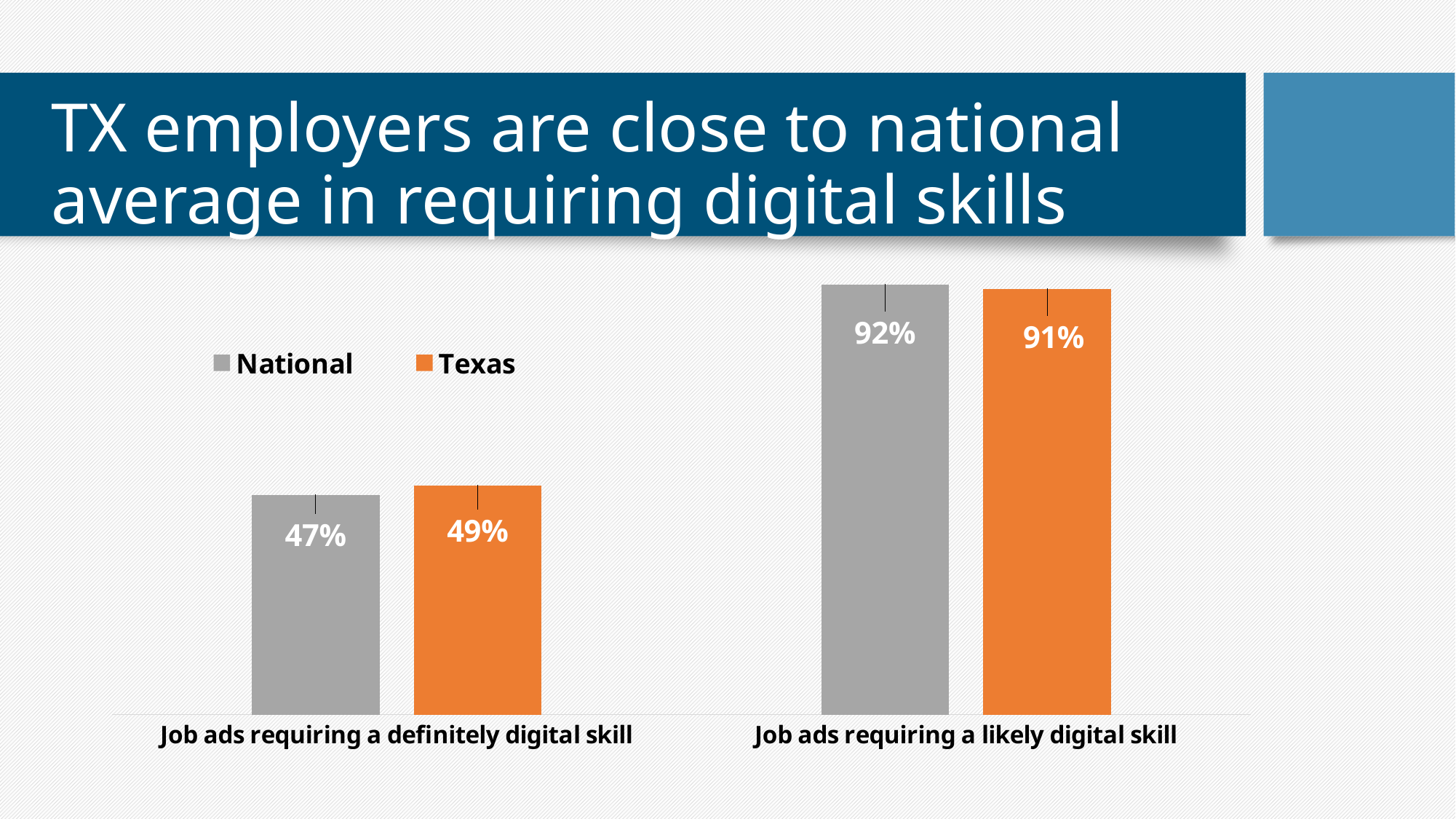
What is the difference between the National and Texas values for job ads requiring a likely digital skill? 1% What is the Texas value for job ads requiring a definitely digital skill? 49% What is the National value for job ads requiring a likely digital skill? 92% Which colour represents the Texas series? Orange What kind of chart is shown on the slide? Bar chart What is the difference between the Texas and National values for job ads requiring a definitely digital skill? 2% How many series does the legend list? 2 Which category has the lowest Texas value? Job ads requiring a definitely digital skill What is the Texas value for job ads requiring a likely digital skill? 91% Which category has the highest National value? Job ads requiring a likely digital skill How many categories are shown on the x axis? 2 What is the National value for job ads requiring a definitely digital skill? 47%